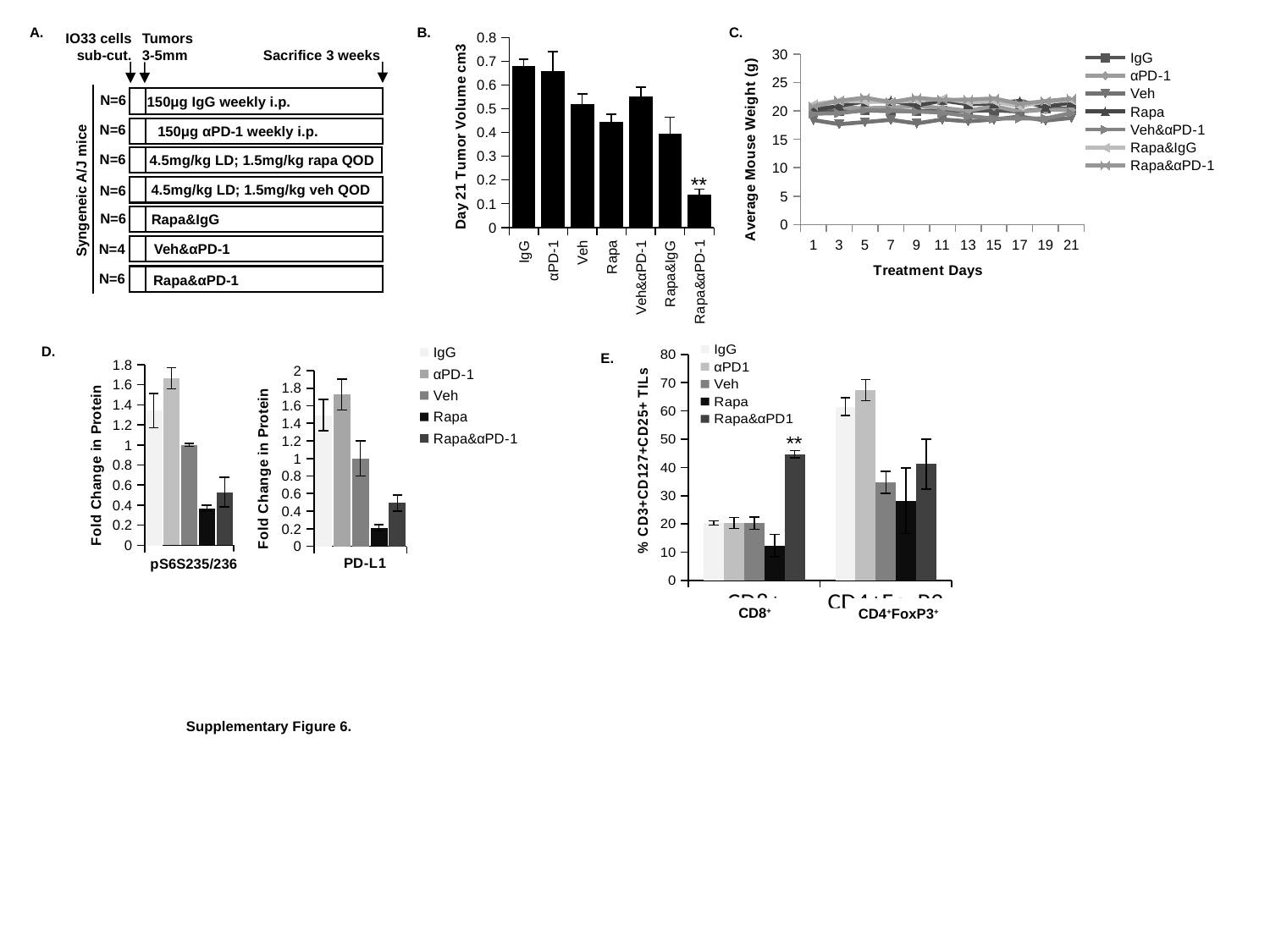
In chart B (Day 21 Tumor Volume), is the value for Rapa&αPD-1 greater or less than 0.2? less In the PD-L1 chart in panel D, which series has the lowest fold change? Rapa In chart B (Day 21 Tumor Volume), how many treatment groups are plotted on the x axis? 7 In chart B (Day 21 Tumor Volume), which is larger, the value for Veh or the value for Rapa&IgG? Veh In chart B (Day 21 Tumor Volume), which treatment group has the lowest tumor volume? Rapa&αPD-1 In chart E (% CD3+CD127+CD25+ TILs), is the value for Veh in the CD4+FoxP3+ group greater or less than 40? less In chart E (% CD3+CD127+CD25+ TILs), which series has the highest value for CD8+? Rapa&αPD1 In chart C (Average Mouse Weight), do the values rise, fall, or stay roughly flat across the treatment days? stay roughly flat What kind of chart is chart C (Average Mouse Weight)? line chart In chart B (Day 21 Tumor Volume), is the value for IgG greater or less than 0.6? greater In the pS6S235/236 chart in panel D, which series has the highest fold change? αPD-1 How many series does the legend of chart C (Average Mouse Weight) list? 7